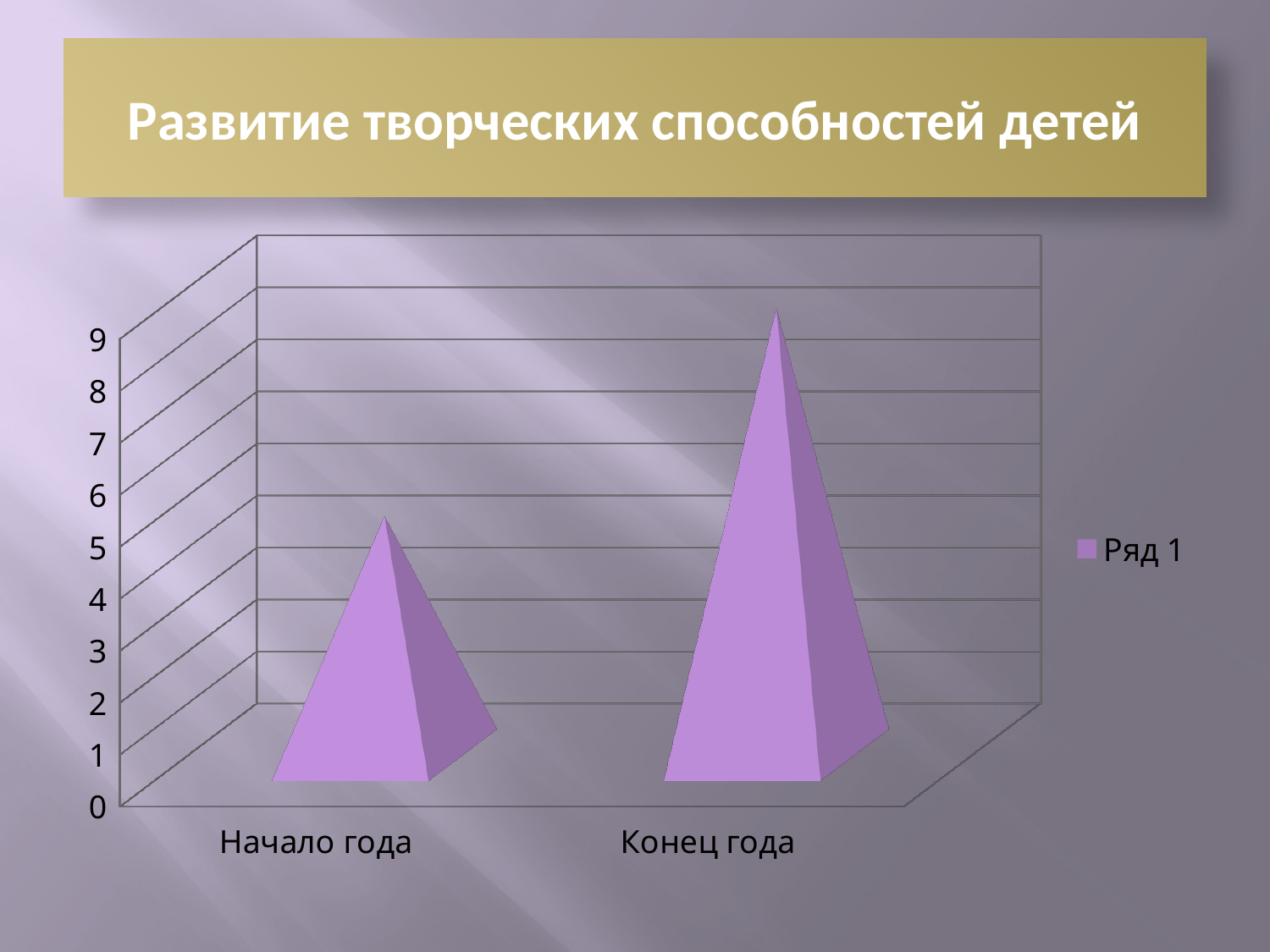
Which category has the highest value in the chart? Конец года Do the values rise or fall from Начало года to Конец года? rise Which is larger, the value for Начало года or the value for Конец года? Конец года What kind of chart is shown on the slide? bar chart What is the title of the slide containing the chart? Развитие творческих способностей детей Which category has the lowest value in the chart? Начало года Is the value for Конец года greater or less than 6? greater What is the name of the series shown in the chart legend? Ряд 1 How many series does the chart legend list? 1 How many categories are shown on the x axis of the chart? 2 Is the value for Начало года greater or less than 8? less